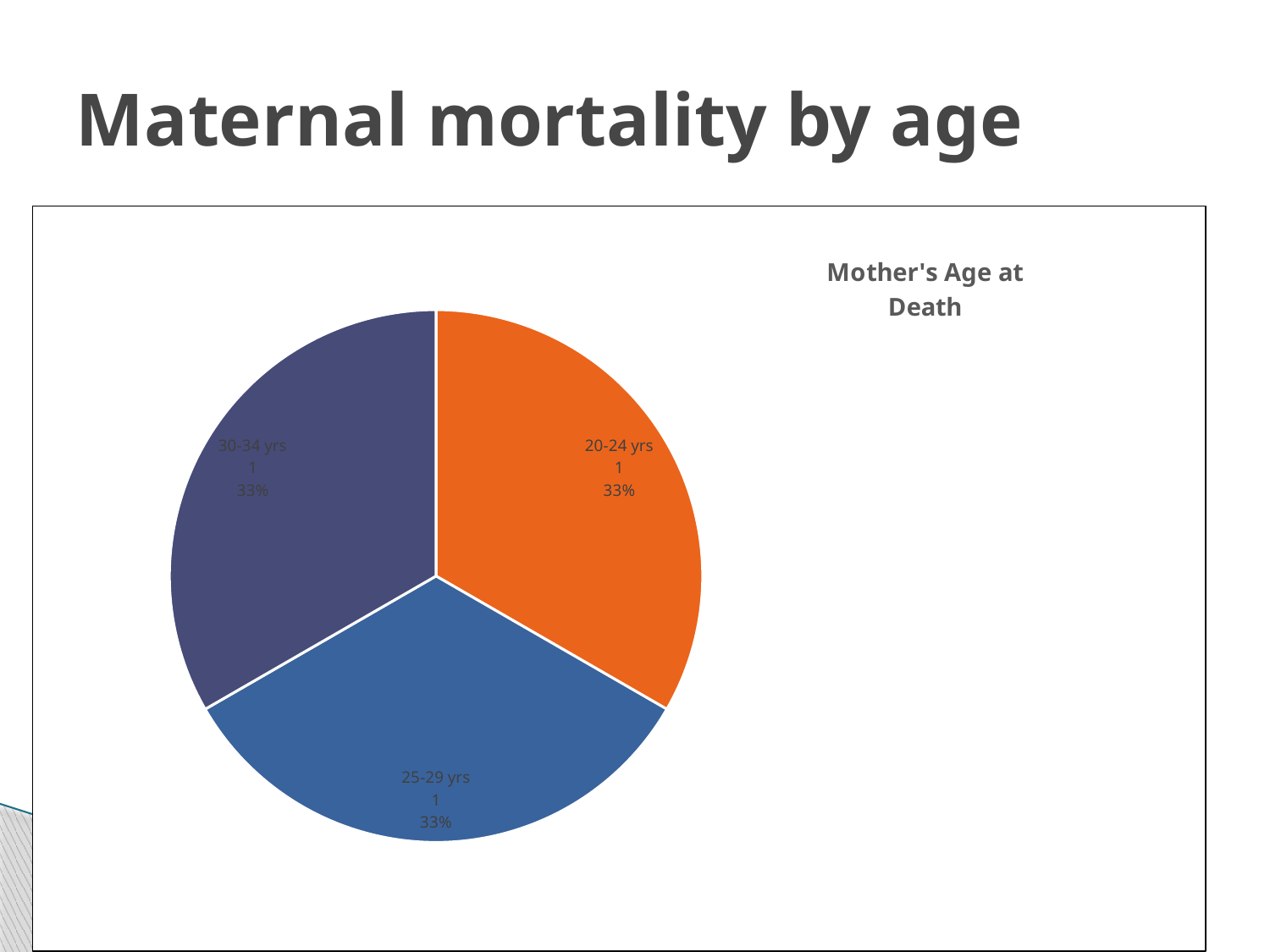
How many slices does the pie chart have? 3 What is the title of the chart? Mother's Age at Death What share of the pie does the 30-34 yrs slice represent? 33% What is the difference between the values for 20-24 yrs and 30-34 yrs? 0 What value is shown for the 20-24 yrs slice? 1 What share of the pie does the 20-24 yrs slice represent? 33% What kind of chart is shown on the slide? pie chart Which slice of the pie is coloured orange? 20-24 yrs What share of the pie does the 25-29 yrs slice represent? 33% What value is shown for the 30-34 yrs slice? 1 What is the total of the values across all three slices? 3 What value is shown for the 25-29 yrs slice? 1